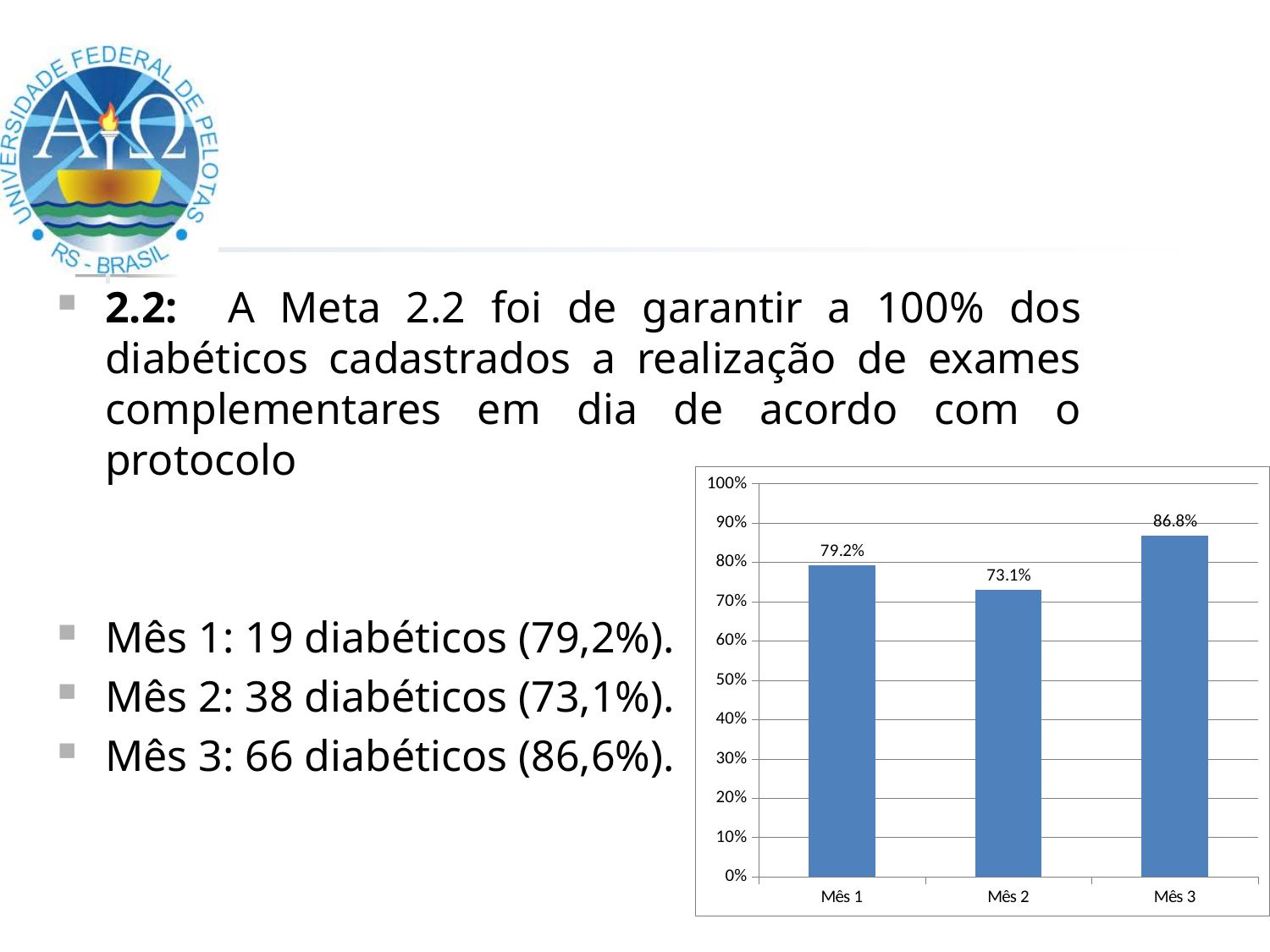
What is the value shown for Mês 1? 79.2% What is the value shown for Mês 2? 73.1% What is the value shown for Mês 3? 86.8% What kind of chart is shown on the slide? Bar chart Which month has the highest value in the chart? Mês 3 Is the value for Mês 3 greater or less than 80%? greater Which is larger, the value for Mês 1 or the value for Mês 2? Mês 1 How many months are shown on the x axis of the chart? 3 What is the maximum value shown on the chart's vertical axis? 100% What is the difference between the values for Mês 1 and Mês 2? 6.1% Which month has the lowest value in the chart? Mês 2 What is the difference between the values for Mês 3 and Mês 1? 7.6%